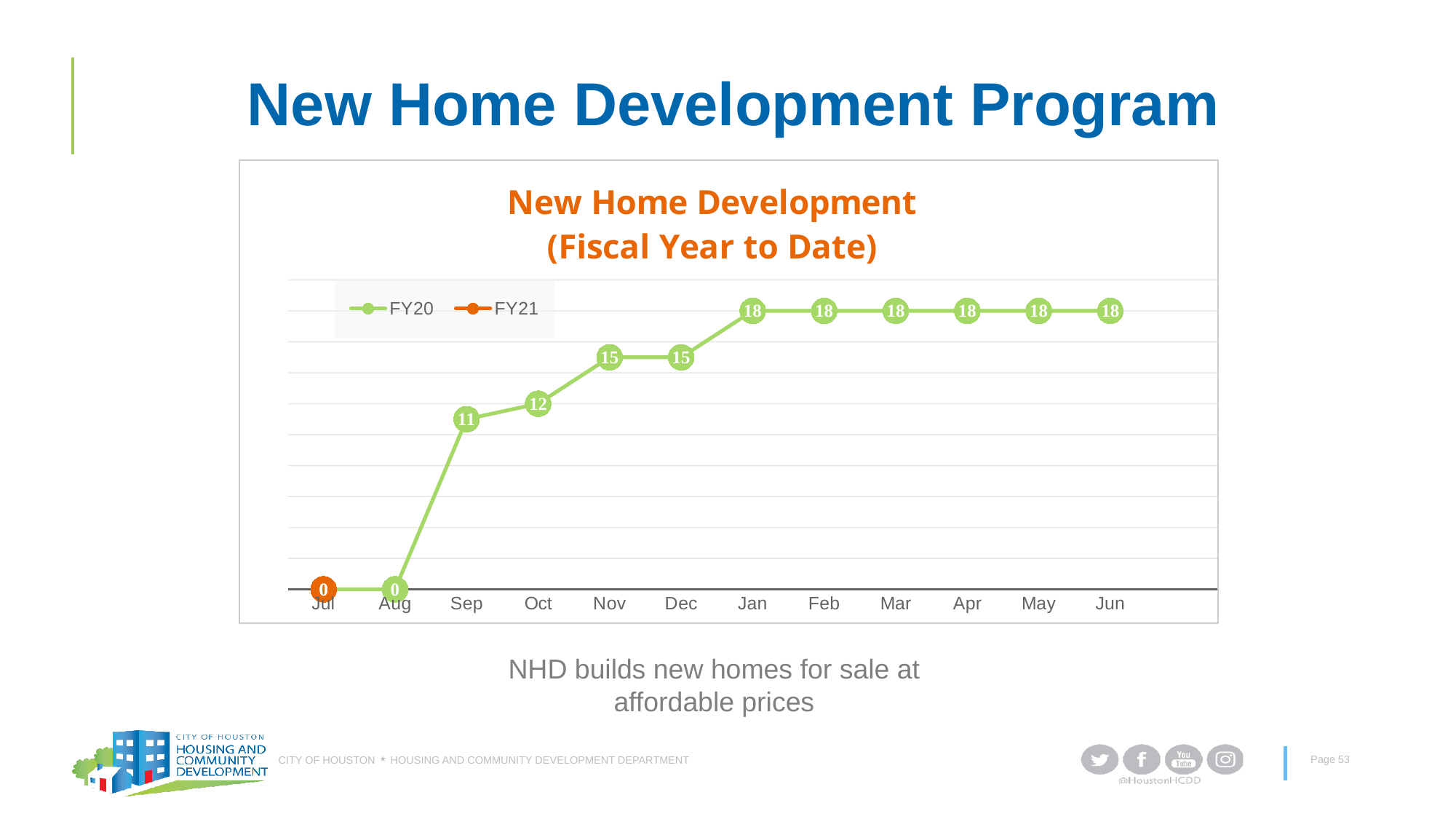
What is the FY20 value for Nov? 15 What is the FY20 value for Oct? 12 Which is larger for FY20, the value for Oct or the value for Nov? Nov What is the title of the chart? New Home Development (Fiscal Year to Date) What is the FY21 value for Jul? 0 What is the difference between the FY20 values for Jan and Dec? 3 How many months are shown on the x axis? 12 How many series does the legend list? 2 What is the FY20 value for Jun? 18 Does the FY20 line rise or fall from Aug to Jan? rise What kind of chart is shown? line chart What is the FY20 value for Sep? 11